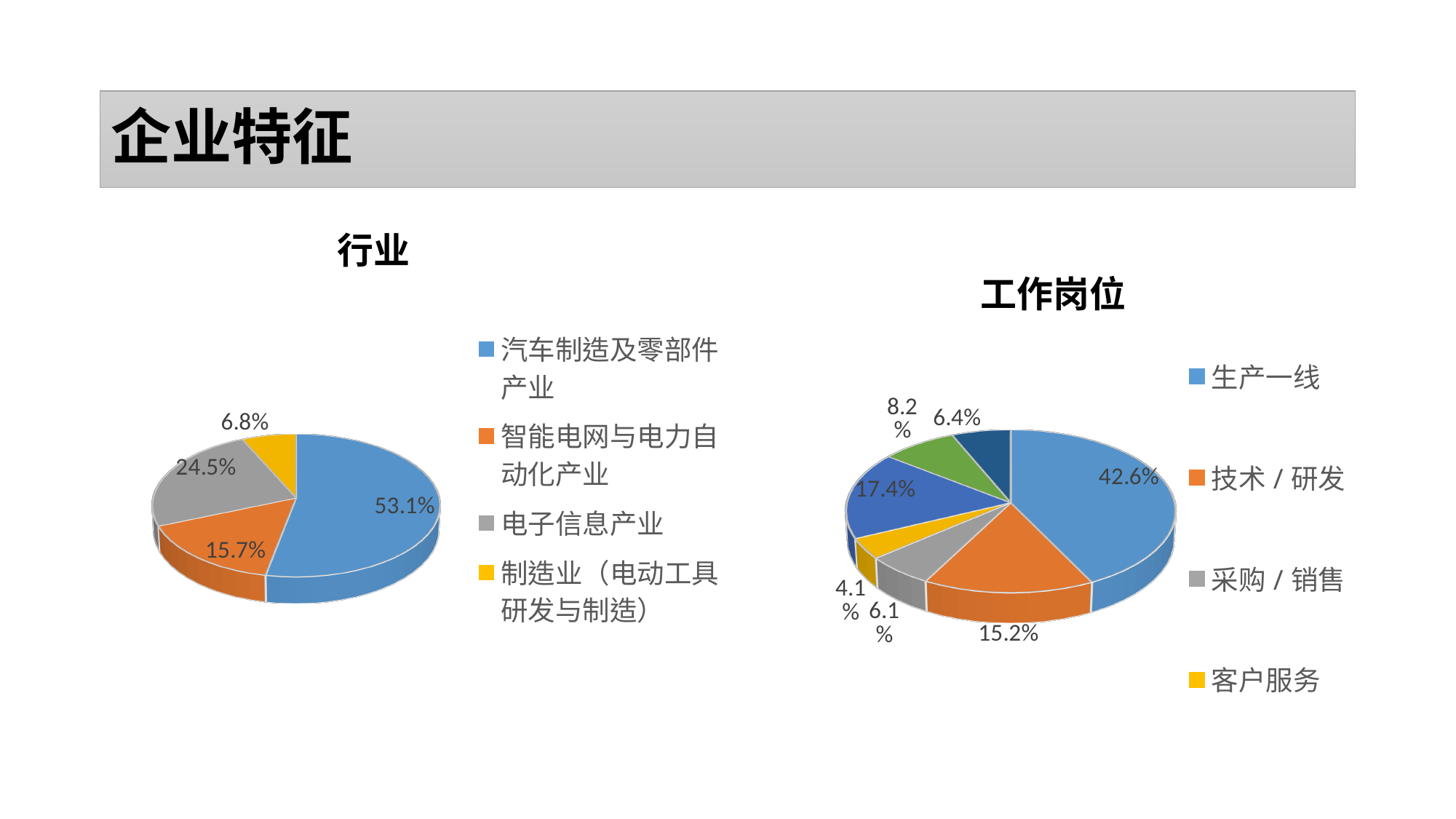
In the 行业 chart, how many slices does the pie have? 4 In the 工作岗位 chart, how many entries does the legend list? 4 What kind of chart is the 行业 chart? Pie chart In the 行业 chart, what percentage is shown for 电子信息产业? 24.5% In the 工作岗位 chart, what percentage is shown for 生产一线? 42.6% In the 行业 chart, what percentage is shown for 汽车制造及零部件产业? 53.1% In the 工作岗位 chart, which is larger, the share for 采购／销售 or the share for 客户服务? 采购／销售 In the 行业 chart, which category has the smallest share? 制造业（电动工具研发与制造） In the 行业 chart, what is the difference between the shares of 电子信息产业 and 智能电网与电力自动化产业? 8.8% In the 工作岗位 chart, what percentage is shown for 技术／研发? 15.2% In the 工作岗位 chart, what percentage is shown for 客户服务? 4.1% In the 行业 chart, what percentage is shown for 智能电网与电力自动化产业? 15.7%